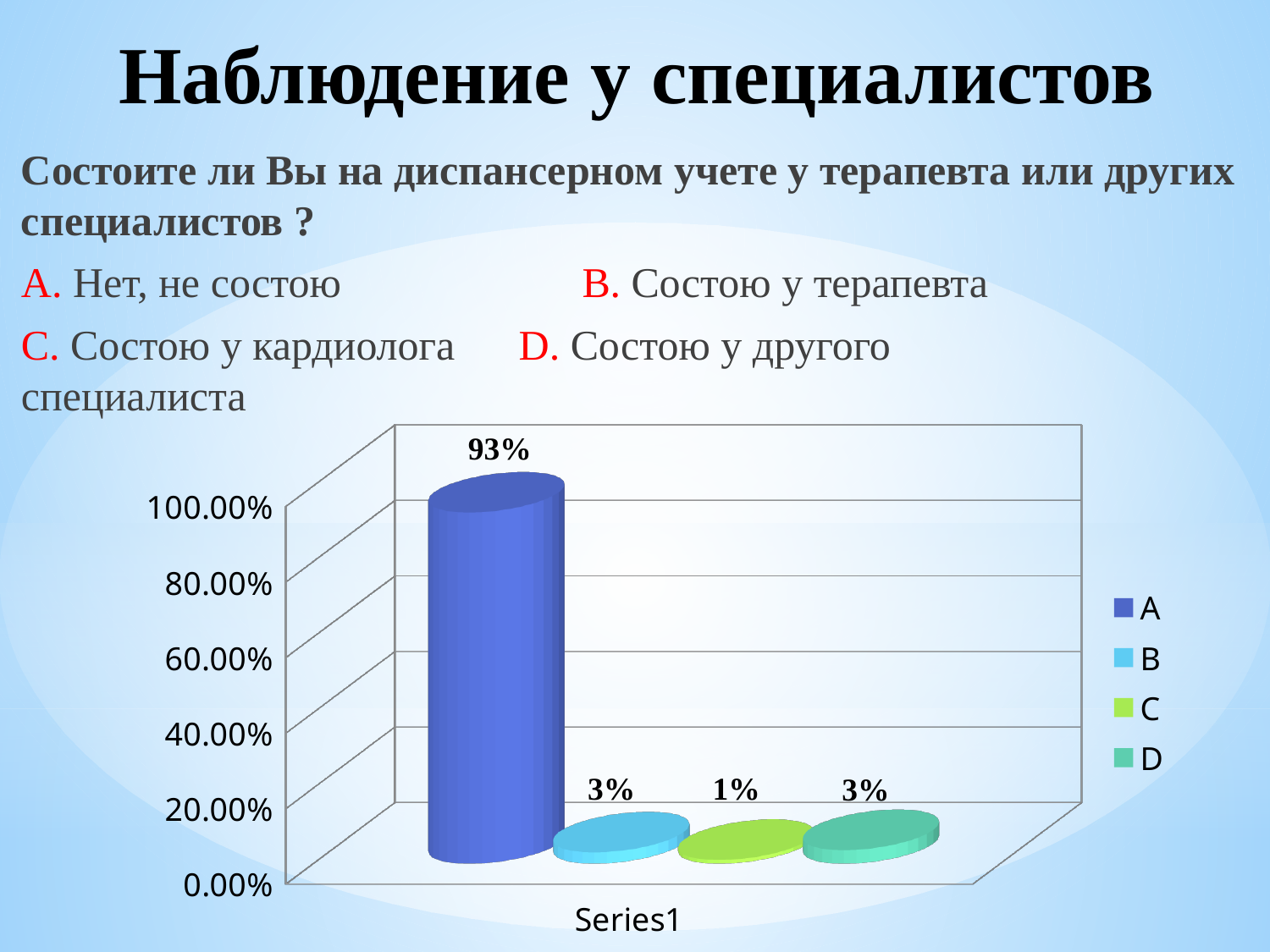
What value is shown for series B? 3% Is the value for series A greater or less than 80.00%? greater What is the label on the horizontal axis of the chart? Series1 What kind of chart is shown on the slide? bar chart Which is larger, the value for series B or the value for series C? B What value is shown for series C? 1% What colour is series A in the legend? blue What is the difference between the values for series A and series B? 90% Which series has the highest value? A Which series has the lowest value? C How many series does the legend list? 4 What value is shown for series A? 93%